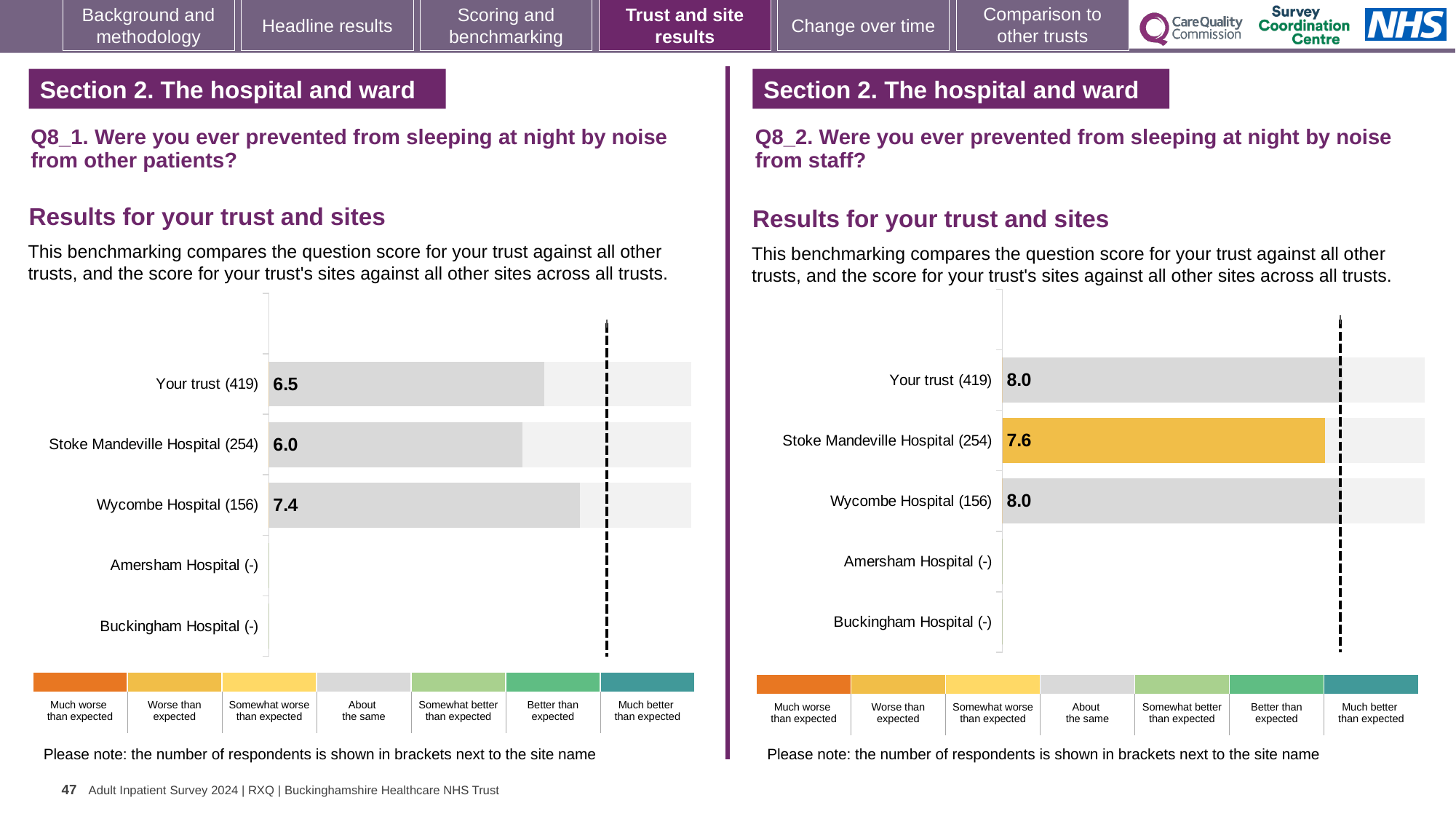
What type of chart is used on the Q8_2 chart (right)? Bar chart On the Q8_2 chart (right), which benchmark category does the colour of the Stoke Mandeville Hospital (254) bar correspond to? Worse than expected Which is larger: the Q8_1 score for Your trust (419) or the Q8_2 score for Your trust (419)? Q8_2 (8.0) On the Q8_2 chart (right), what is the score for Stoke Mandeville Hospital (254)? 7.6 On the Q8_1 chart (left), what is the score for Your trust (419)? 6.5 On the Q8_1 chart (left), what is the difference between the scores for Wycombe Hospital (156) and Stoke Mandeville Hospital (254)? 1.4 On the Q8_2 chart (right), which site has the lowest score? Stoke Mandeville Hospital (254) On the Q8_1 chart (left), which site or trust has the lowest score? Stoke Mandeville Hospital (254) On the Q8_1 chart (left), what is the score for Wycombe Hospital (156)? 7.4 On the Q8_1 chart (left), how many sites or trusts have a score bar plotted? 3 On the Q8_2 chart (right), what is the difference between the scores for Wycombe Hospital (156) and Stoke Mandeville Hospital (254)? 0.4 On the Q8_2 chart (right), what is the score for Your trust (419)? 8.0